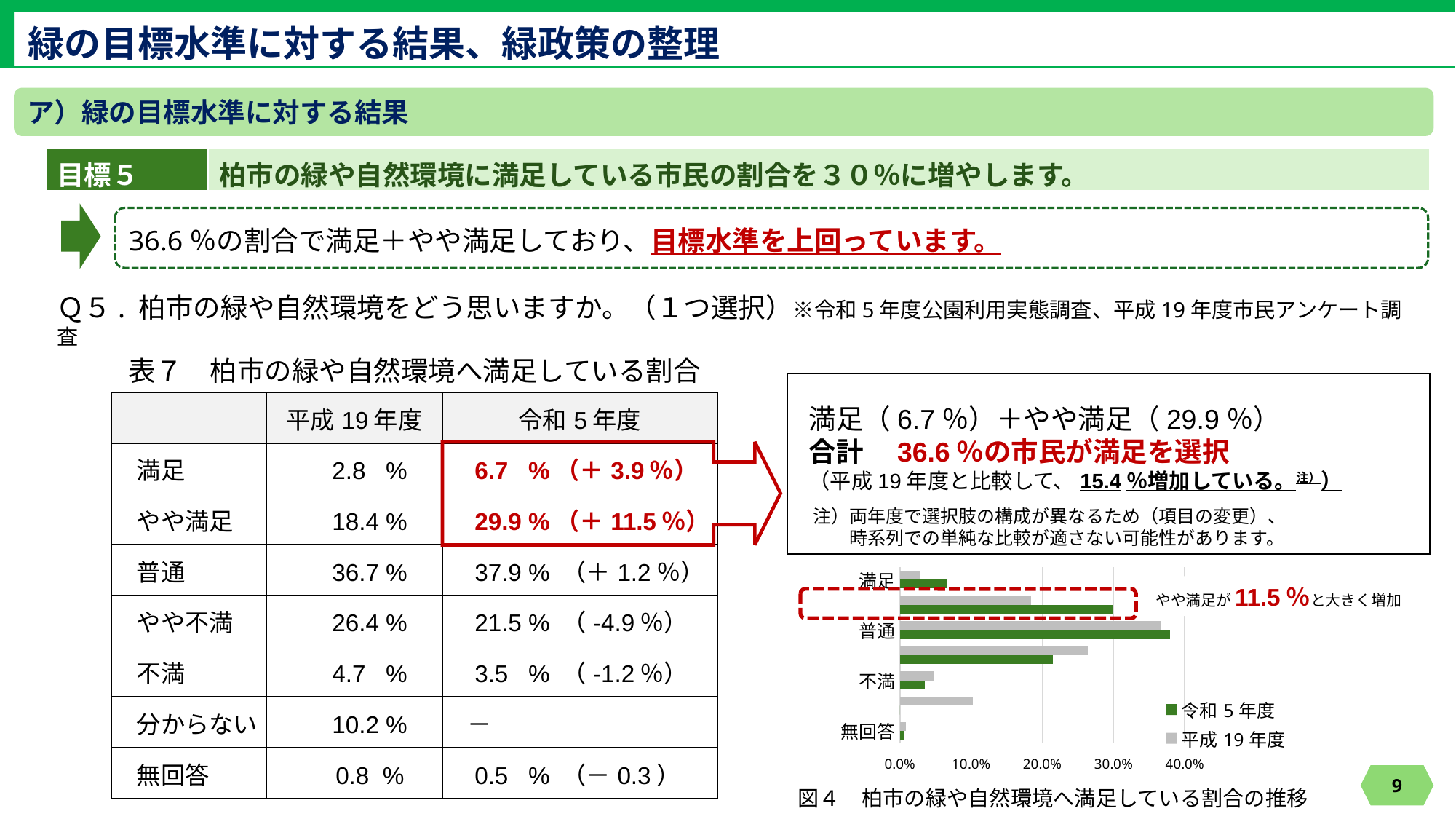
In 図4, for 不満, which year has the larger value, 令和5年度 or 平成19年度? 平成19年度 In 図4, is the 平成19年度 value for 無回答 greater or less than 10.0%? less What kind of chart is 図4 (柏市の緑や自然環境へ満足している割合の推移)? Horizontal bar chart What are the two legend entries in 図4? 令和5年度 and 平成19年度 What is the caption of the bar chart on the slide? 図4 柏市の緑や自然環境へ満足している割合の推移 In 図4, is the 平成19年度 value for 普通 greater or less than 30.0%? greater In 図4, is the 令和5年度 value for 満足 greater or less than 10.0%? less According to the annotation on 図4, by how much did やや満足 increase? 11.5% In 図4, which category has the longest 令和5年度 bar? 普通 In 図4, for 普通, which year has the larger value, 令和5年度 or 平成19年度? 令和5年度 How many series does the legend of 図4 list? 2